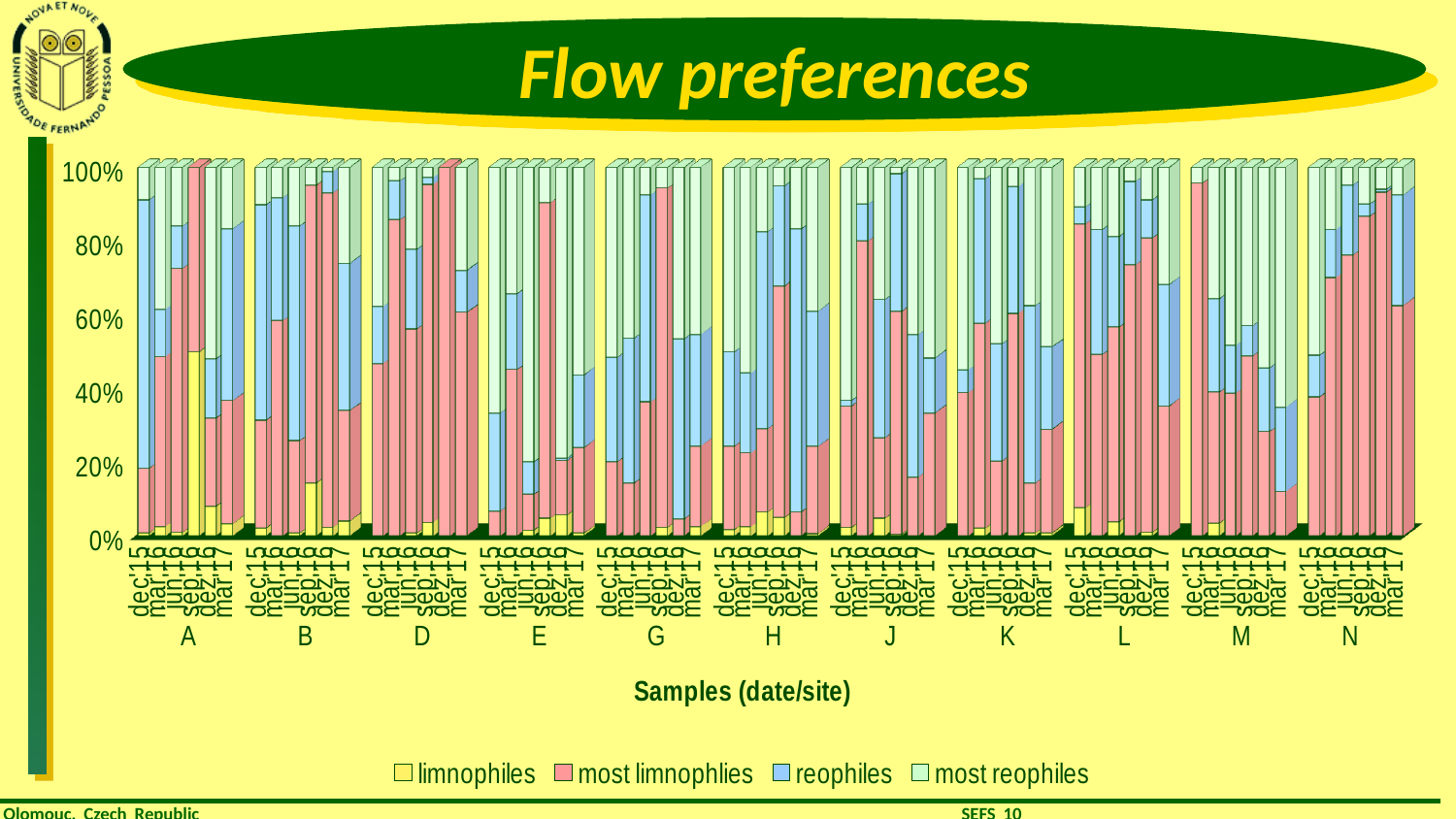
In the first bar (dec'15) of site L, is the share of most limnophlies greater or less than 60%? greater In the first bar (dec'15) of site D, is the share of most limnophlies greater or less than 60%? less What is the total height of each stacked bar in the chart? 100% In the first bar (dec'15) of site A, is the share of most limnophlies greater or less than 40%? less How many series does the legend list? 4 What kind of chart is shown on the slide? Stacked bar chart What is the x-axis title of the chart? Samples (date/site) What is the highest value shown on the y axis? 100% What is the title of the chart? Flow preferences How many sample bars are shown for each site? 6 How many sites (letter groups) are shown along the x axis? 11